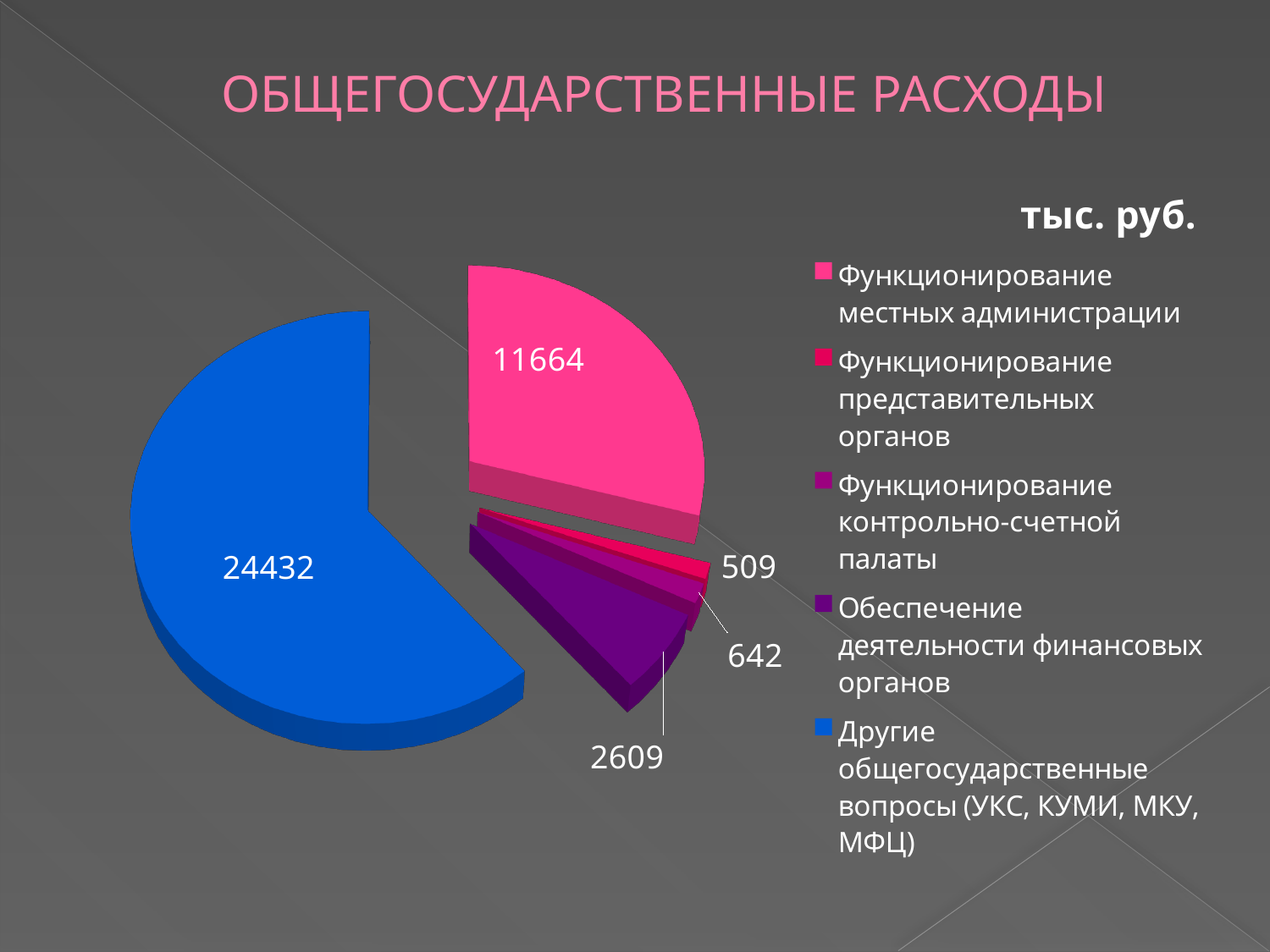
What is the value for Функционирование контрольно-счетной палаты? 642 What is the value for Обеспечение деятельности финансовых органов? 2609 How many categories does the pie chart have? 5 What is the value for Функционирование представительных органов? 509 What is the difference between the values for Другие общегосударственные вопросы and Функционирование местных администрации? 12768 Which category has the smallest slice of the pie? Функционирование представительных органов What unit is indicated above the legend? тыс. руб. What kind of chart is shown on the slide? pie chart Which is larger: Функционирование контрольно-счетной палаты or Функционирование представительных органов? Функционирование контрольно-счетной палаты What is the value for Функционирование местных администрации? 11664 What is the value for Другие общегосударственные вопросы (УКС, КУМИ, МКУ, МФЦ)? 24432 Which category has the largest slice of the pie? Другие общегосударственные вопросы (УКС, КУМИ, МКУ, МФЦ)